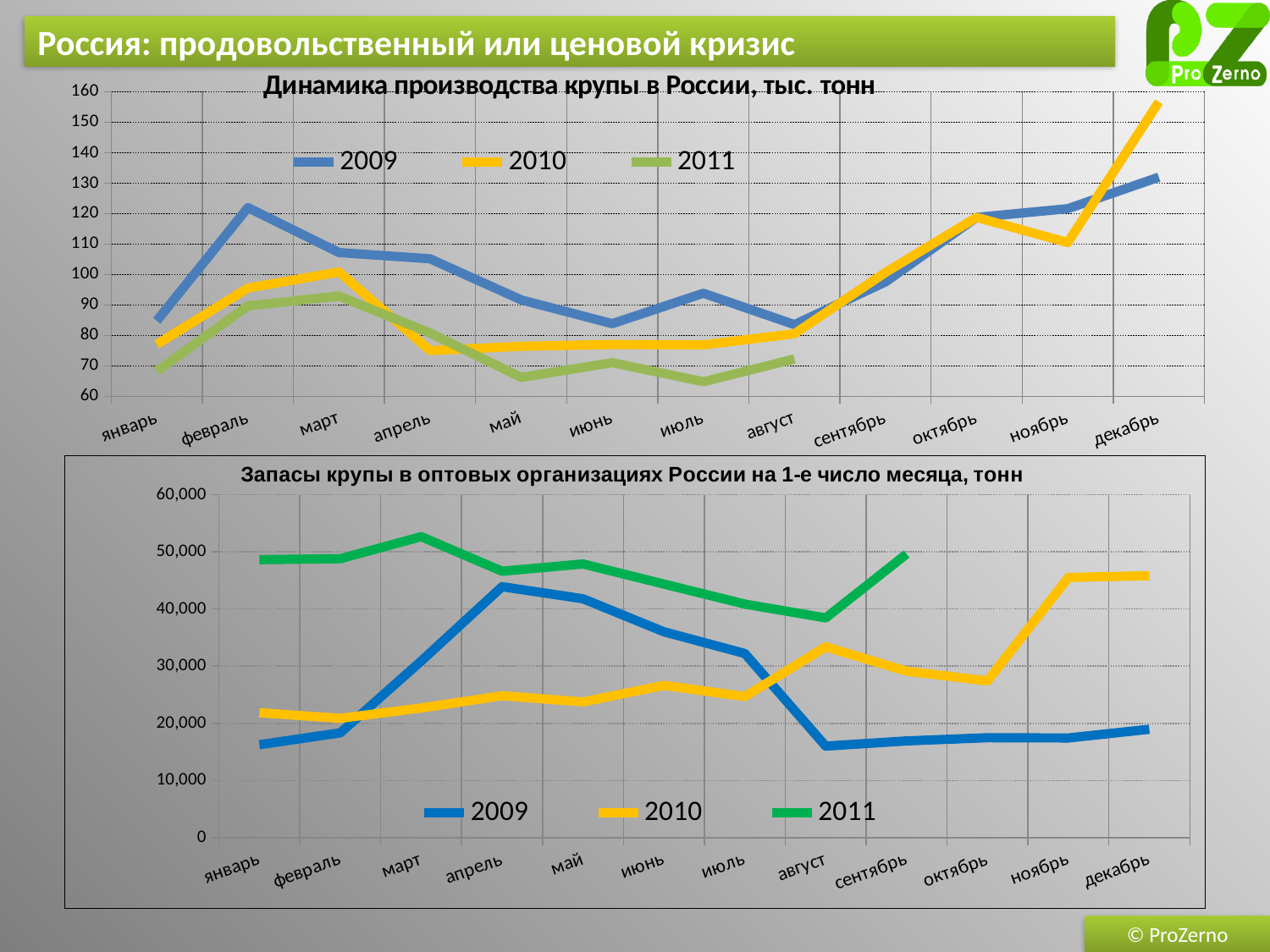
In the bottom chart, is the 2011 value for март greater or less than 50,000? greater How many series does the legend of the top chart list? 3 In the top chart, is the 2011 value for июль greater or less than 70? less In the top chart, is the 2010 value for декабрь greater or less than 150? greater In the top chart, which series has the highest value in февраль, 2009 or 2010? 2009 In the top chart, in which month does the 2010 series reach its highest value? декабрь How many months are shown on the x axis of the bottom chart, 'Запасы крупы в оптовых организациях России'? 12 What is the title of the bottom chart? Запасы крупы в оптовых организациях России на 1-е число месяца, тонн In the bottom chart, which series has the higher value in апрель, 2010 or 2011? 2011 What kind of chart is the top chart, 'Динамика производства крупы в России, тыс. тонн'? line chart In the top chart, does the 2009 series rise or fall from август to декабрь? rise